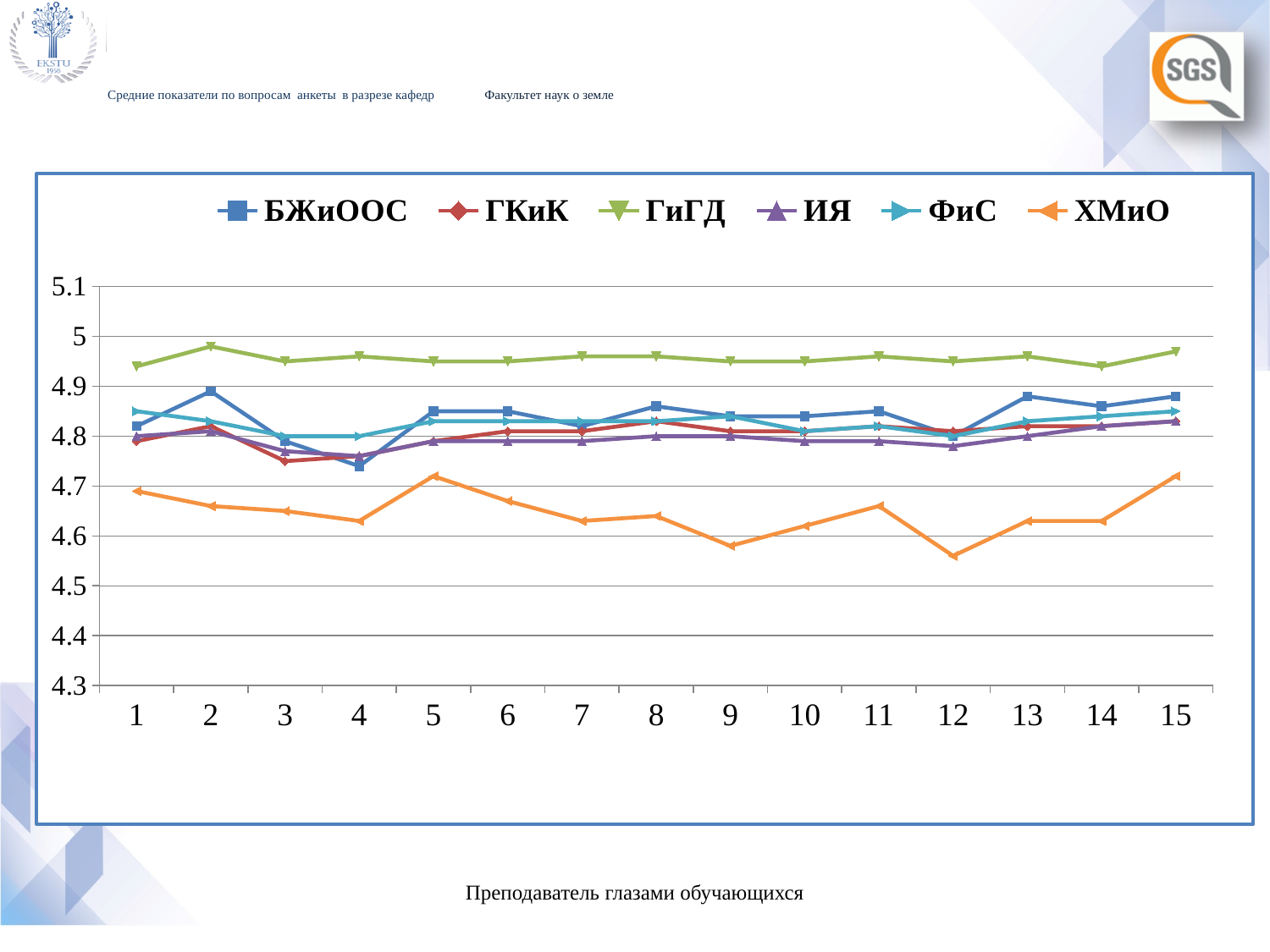
How many points are there along the x axis? 15 Is the value for ГиГД at point 2 greater or less than 4.9? greater What kind of chart is shown on the slide? line chart Which series has the highest values across the chart? ГиГД At which x-axis point does the БЖиООС series reach its lowest value? 4 Which series is drawn in orange? ХМиО Is the value for БЖиООС at point 4 greater or less than 4.8? less Which series has the lowest values across the chart? ХМиО Is the value for ХМиО at point 12 greater or less than 4.6? less At point 2, which is higher: БЖиООС or ГКиК? БЖиООС How many series does the legend list? 6